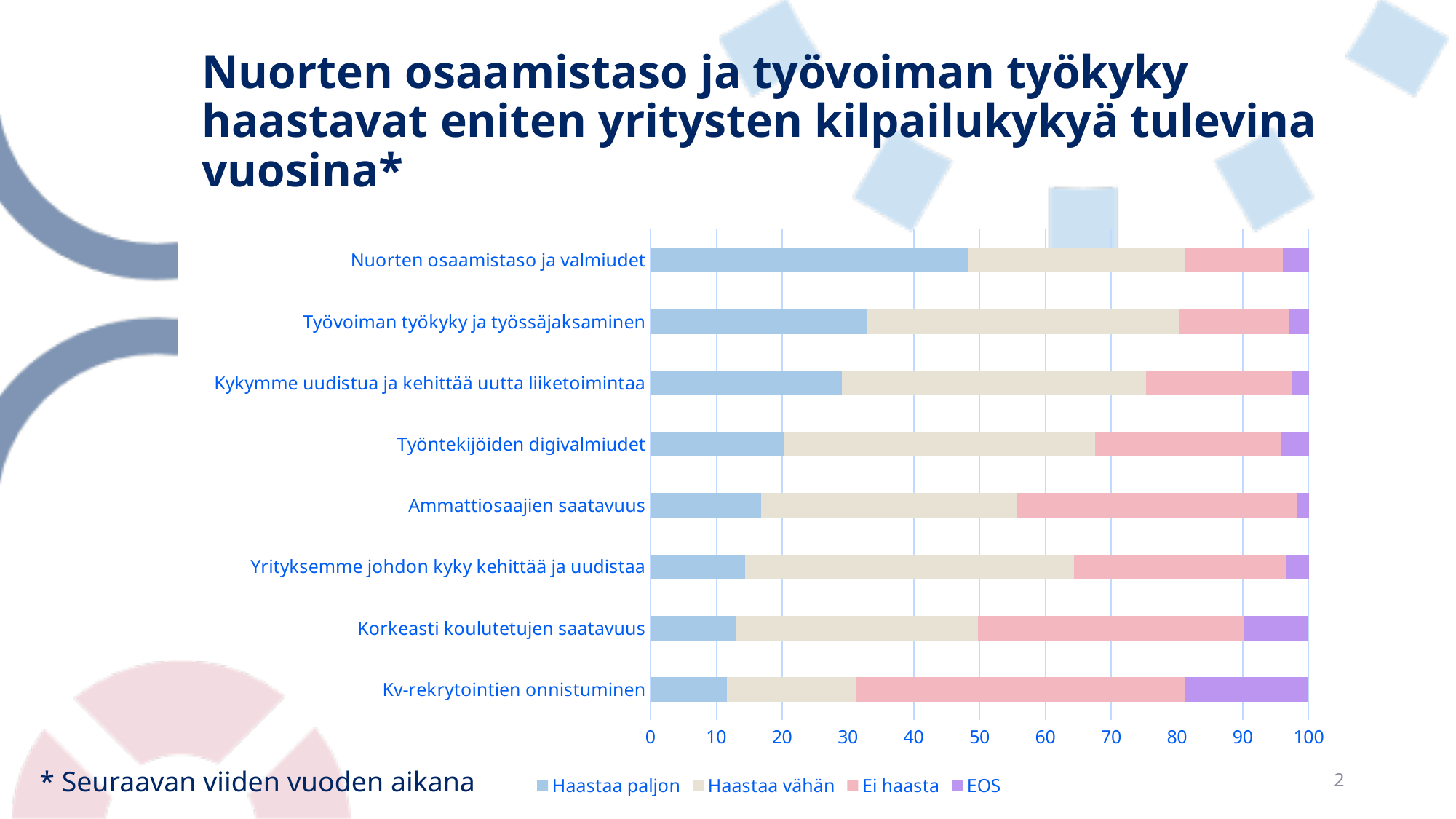
Which category has the largest 'EOS' segment? Kv-rekrytointien onnistuminen How many series does the legend list? 4 Which category has the highest value for the 'Haastaa paljon' series? Nuorten osaamistaso ja valmiudet Is the 'Haastaa paljon' value for Työvoiman työkyky ja työssäjaksaminen greater or less than 40? less How many categories are plotted on the chart? 8 Is the 'Haastaa paljon' value for Nuorten osaamistaso ja valmiudet greater or less than 40? greater Which category has the largest 'Ei haasta' segment? Kv-rekrytointien onnistuminen Which has a larger 'EOS' segment: Kv-rekrytointien onnistuminen or Korkeasti koulutetujen saatavuus? Kv-rekrytointien onnistuminen Is the 'Haastaa paljon' value for Kv-rekrytointien onnistuminen greater or less than 20? less What are the four legend entries of the chart? Haastaa paljon, Haastaa vähän, Ei haasta, EOS What kind of chart is shown on the slide? Stacked bar chart Which has a larger 'Haastaa paljon' value: Nuorten osaamistaso ja valmiudet or Työvoiman työkyky ja työssäjaksaminen? Nuorten osaamistaso ja valmiudet